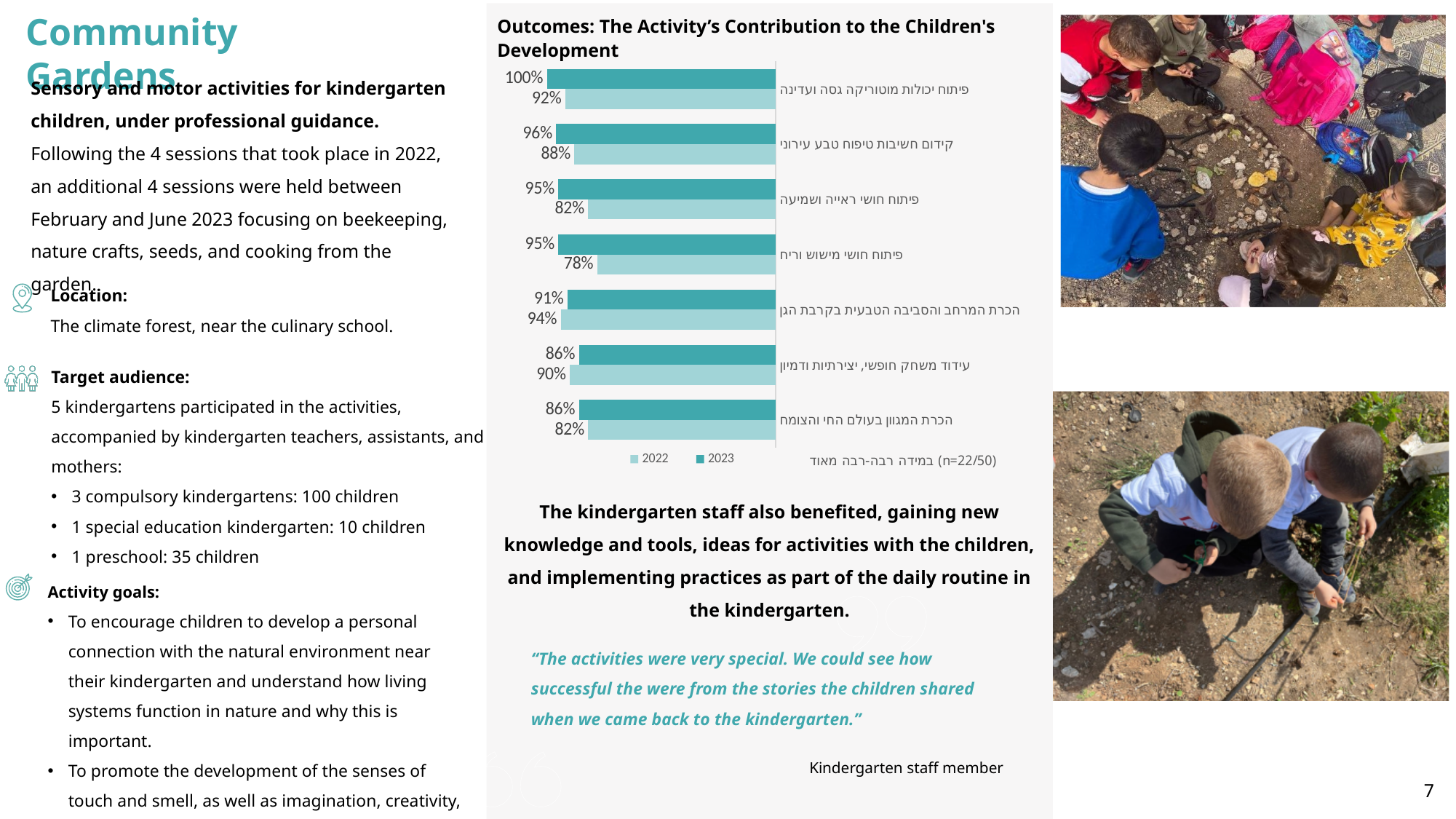
What sample size note is shown below the chart legend? (n=22/50) What is the 2023 value for "פיתוח יכולות מוטוריקה גסה ועדינה"? 100% Which category has the highest 2023 value? פיתוח יכולות מוטוריקה גסה ועדינה How many categories are plotted in the chart? 7 Which category has the lowest 2022 value? פיתוח חושי מישוש וריח What is the 2022 value for "פיתוח חושי מישוש וריח"? 78% What is the 2022 value for "קידום חשיבות טיפוח טבע עירוני"? 88% For "הכרת המרחב והסביבה הטבעית בקרבת הגן", which year has the larger value, 2022 or 2023? 2022 What is the difference between the 2023 and 2022 values for "פיתוח חושי ראייה ושמיעה"? 13% What type of chart is shown under the title "Outcomes: The Activity's Contribution to the Children's Development"? Bar chart How many series does the legend of the chart list? 2 What is the 2023 value for "הכרת המגוון בעולם החי והצומח"? 86%